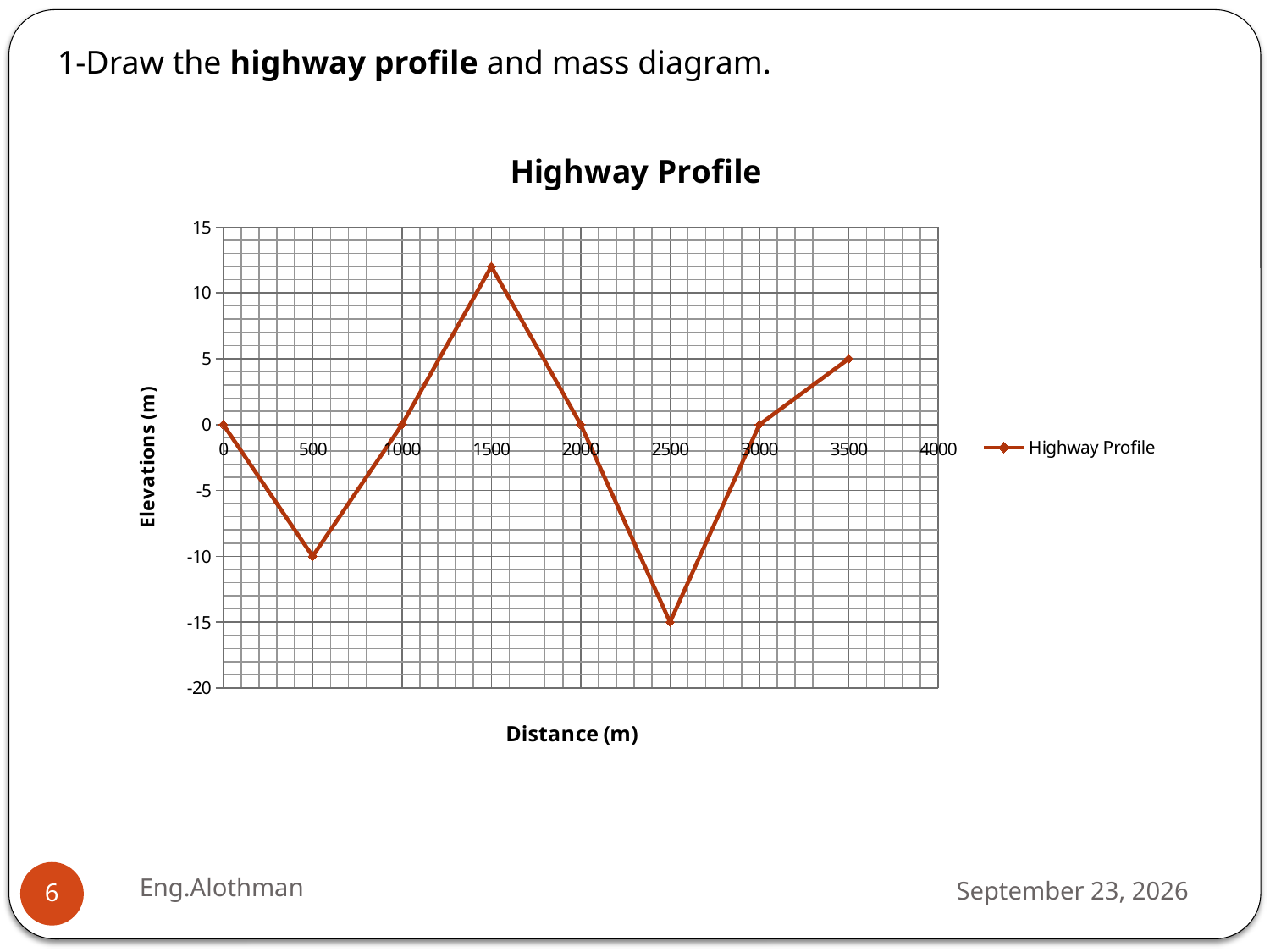
What type of chart is shown on the slide? line chart What is the elevation at a distance of 3500 m? 5 How many series does the legend list? 1 What is the elevation at a distance of 2500 m? -15 Is the elevation at 1500 m greater or less than 10? greater What is the title of the chart? Highway Profile At which distance does the highway profile reach its lowest elevation? 2500 Does the elevation rise or fall between 2500 m and 3500 m? rise Which has the higher elevation, the point at 500 m or the point at 2500 m? 500 m What is the elevation at a distance of 500 m? -10 How many data points are plotted on the Highway Profile line? 8 At which distance does the highway profile reach its highest elevation? 1500